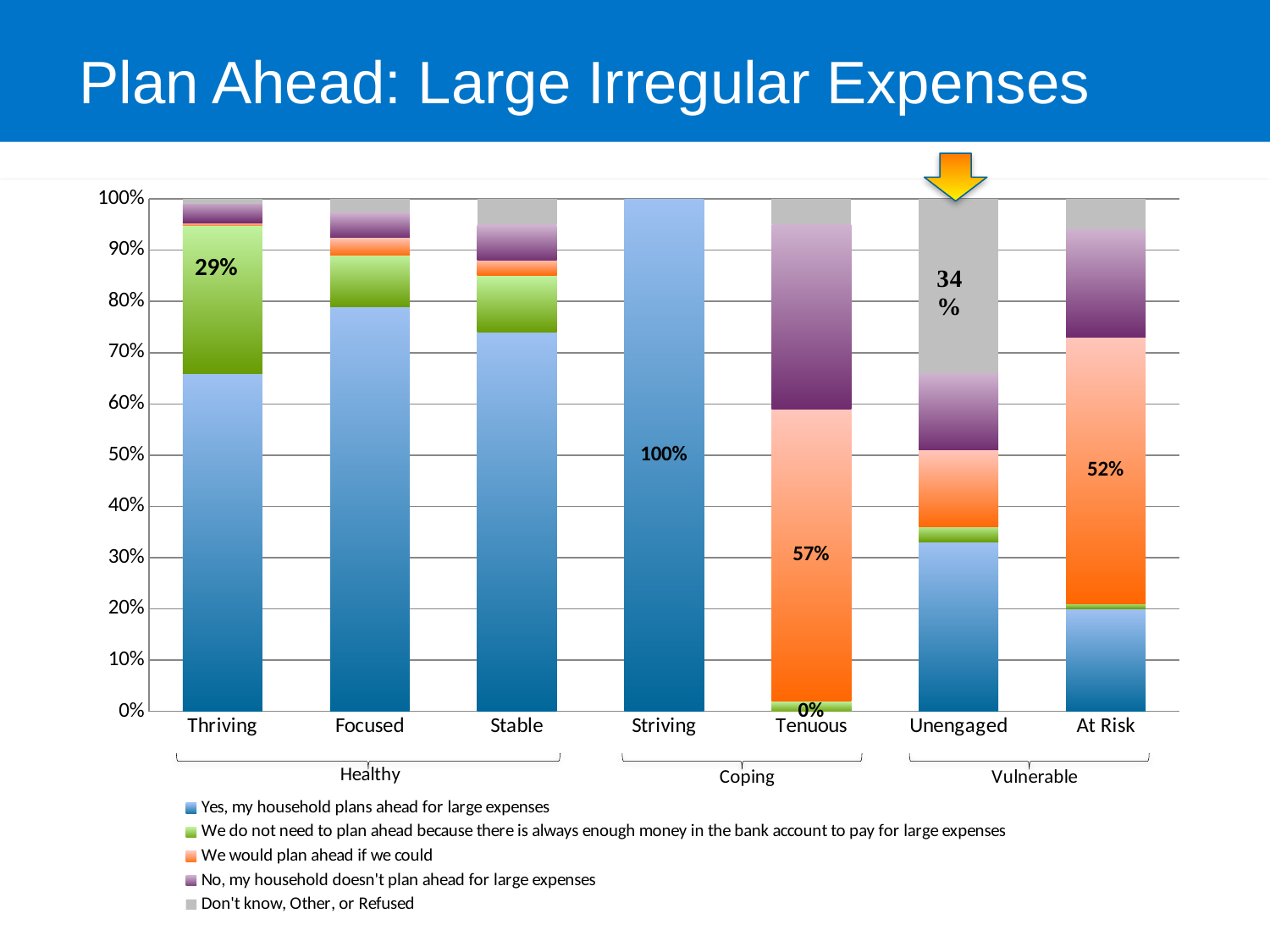
How many categories are shown along the x axis of the chart? 7 What is the labelled value for 'We do not need to plan ahead because there is always enough money in the bank account to pay for large expenses' in the Thriving category? 29% Which is larger: the 'We would plan ahead if we could' value for Tenuous or for At Risk? Tenuous What is the labelled value for 'Yes, my household plans ahead for large expenses' in the Striving category? 100% What is the labelled value for 'We would plan ahead if we could' in the At Risk category? 52% Is the value for 'Yes, my household plans ahead for large expenses' in the Focused category greater or less than 70%? greater What is the labelled value for 'We would plan ahead if we could' in the Tenuous category? 57% How many series does the chart's legend list? 5 What type of chart is shown on the slide? stacked bar chart What is the labelled value for 'Don't know, Other, or Refused' in the Unengaged category? 34% Which category has the highest value for 'Yes, my household plans ahead for large expenses'? Striving